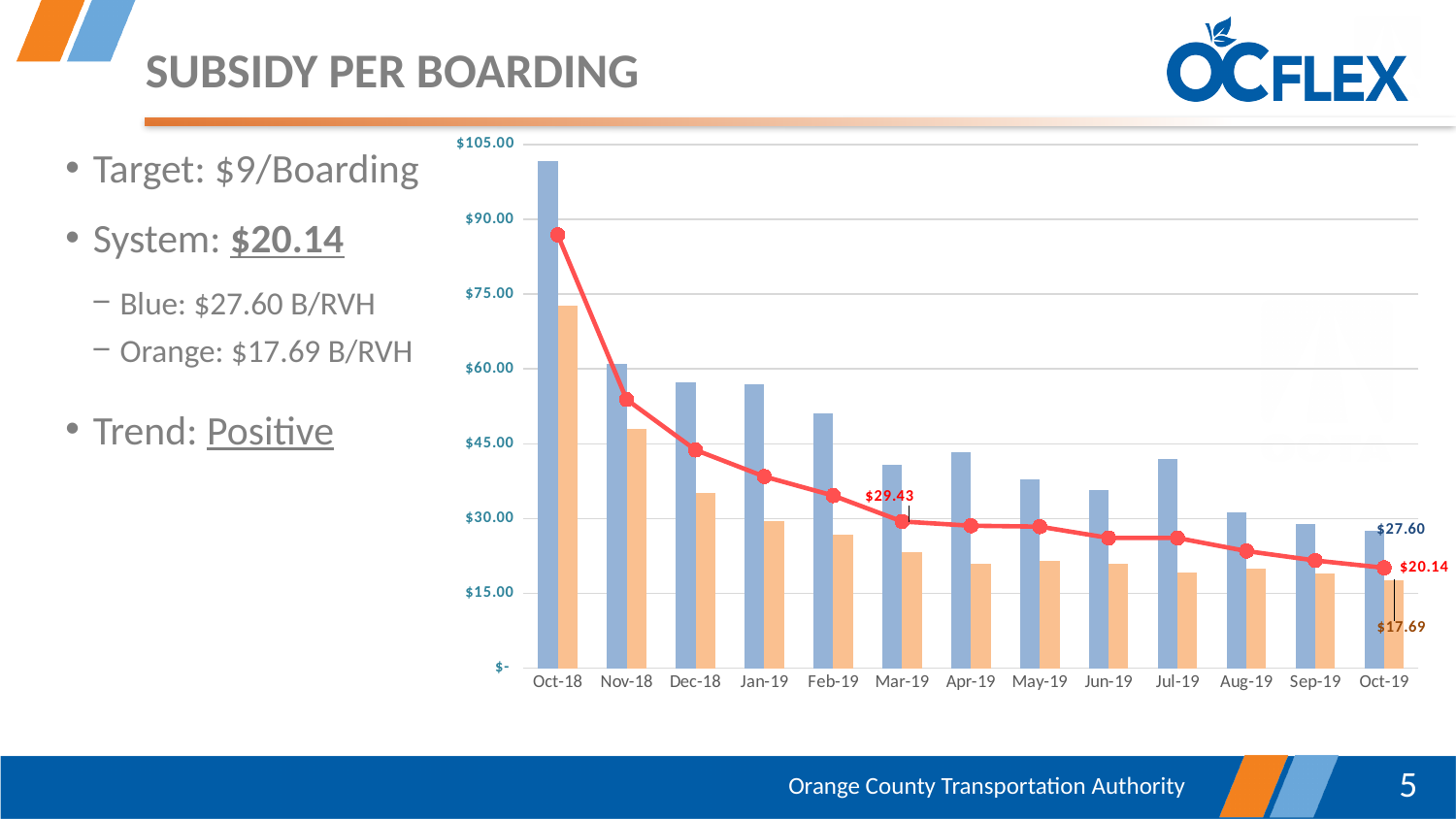
What is the difference between the blue bar and the orange bar for Oct-19? $9.91 In which month is the blue bar highest? Oct-18 How many months are shown on the x axis of the chart? 13 What kind of chart is shown on the slide? Bar chart with a line What value is labeled on the red line at Oct-19? $20.14 What is the value of the orange bar for Oct-19? $17.69 Is the value of the orange bar for Oct-18 greater or less than $75.00? less For Oct-18, which is larger, the blue bar or the orange bar? The blue bar What value is labeled on the red line at Mar-19? $29.43 Is the value of the blue bar for Oct-18 greater or less than $90.00? greater Do the values of the red line rise or fall from Oct-18 to Oct-19? Fall What is the value of the blue bar for Oct-19? $27.60